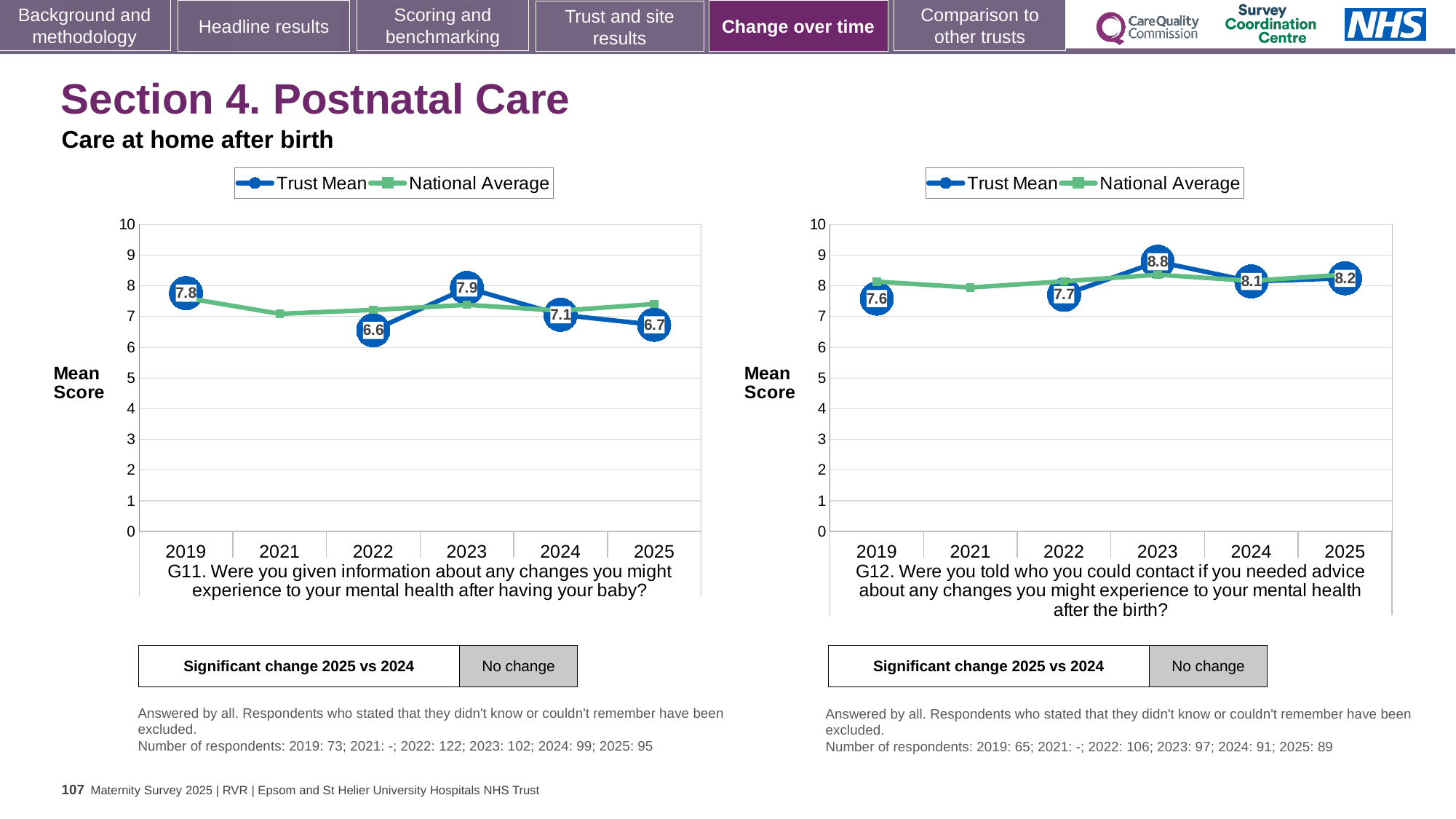
In the G11 chart on the left, what is the Trust Mean for 2023? 7.9 How many series does the legend of the G12 chart on the right list? 2 In the G12 chart on the right, is the National Average for 2021 greater or less than 9? less In the G12 chart on the right, which year has the highest Trust Mean? 2023 How many years are shown on the x axis of the G11 chart on the left? 6 In the G11 chart on the left, which year has the lowest Trust Mean? 2022 In the G12 chart on the right, what is the Trust Mean for 2025? 8.2 What type of chart is the G11 chart on the left? Line chart In the G12 chart on the right, does the Trust Mean rise or fall from 2019 to 2023? Rise In the G11 chart on the left, what is the difference between the Trust Mean in 2023 and in 2022? 1.3 In the G11 chart on the left, is the Trust Mean higher in 2019 or in 2025? 2019 In the G12 chart on the right, what is the difference between the Trust Mean in 2023 and in 2019? 1.2